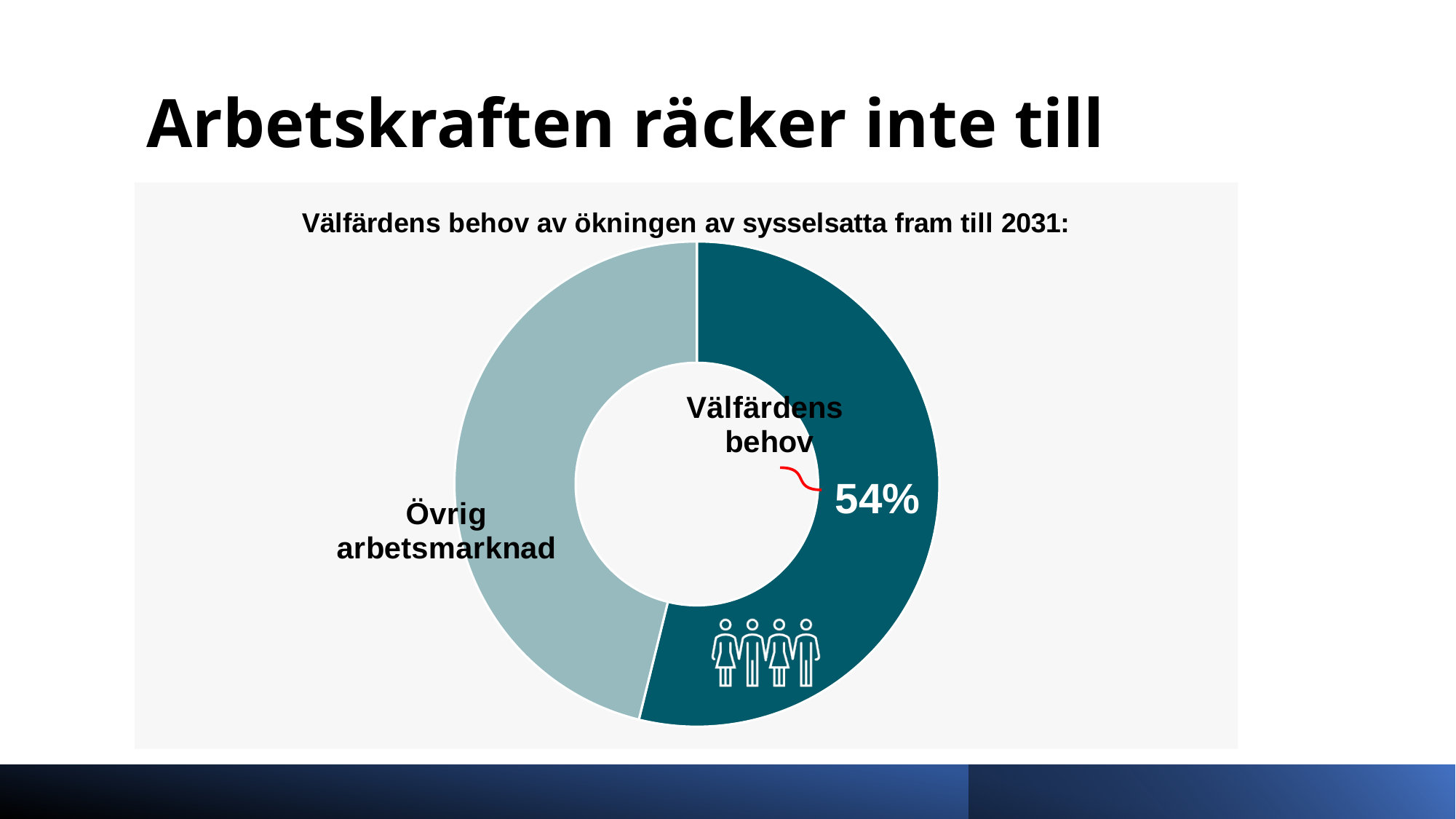
Which slice is the largest in the pie chart? Välfärdens behov Which slice is the smallest in the pie chart? Övrig arbetsmarknad What is the value printed for the Välfärdens behov slice? 54% What share of the pie does Välfärdens behov represent? 54% Which is larger, the Välfärdens behov slice or the Övrig arbetsmarknad slice? Välfärdens behov Is the share for Välfärdens behov greater or less than 50%? greater How many slices does the pie chart have? 2 What kind of chart is shown on the slide? Pie chart (donut) Which slice is drawn in the dark teal colour? Välfärdens behov Is the share for Övrig arbetsmarknad greater or less than 50%? less What is the title of the chart? Välfärdens behov av ökningen av sysselsatta fram till 2031: